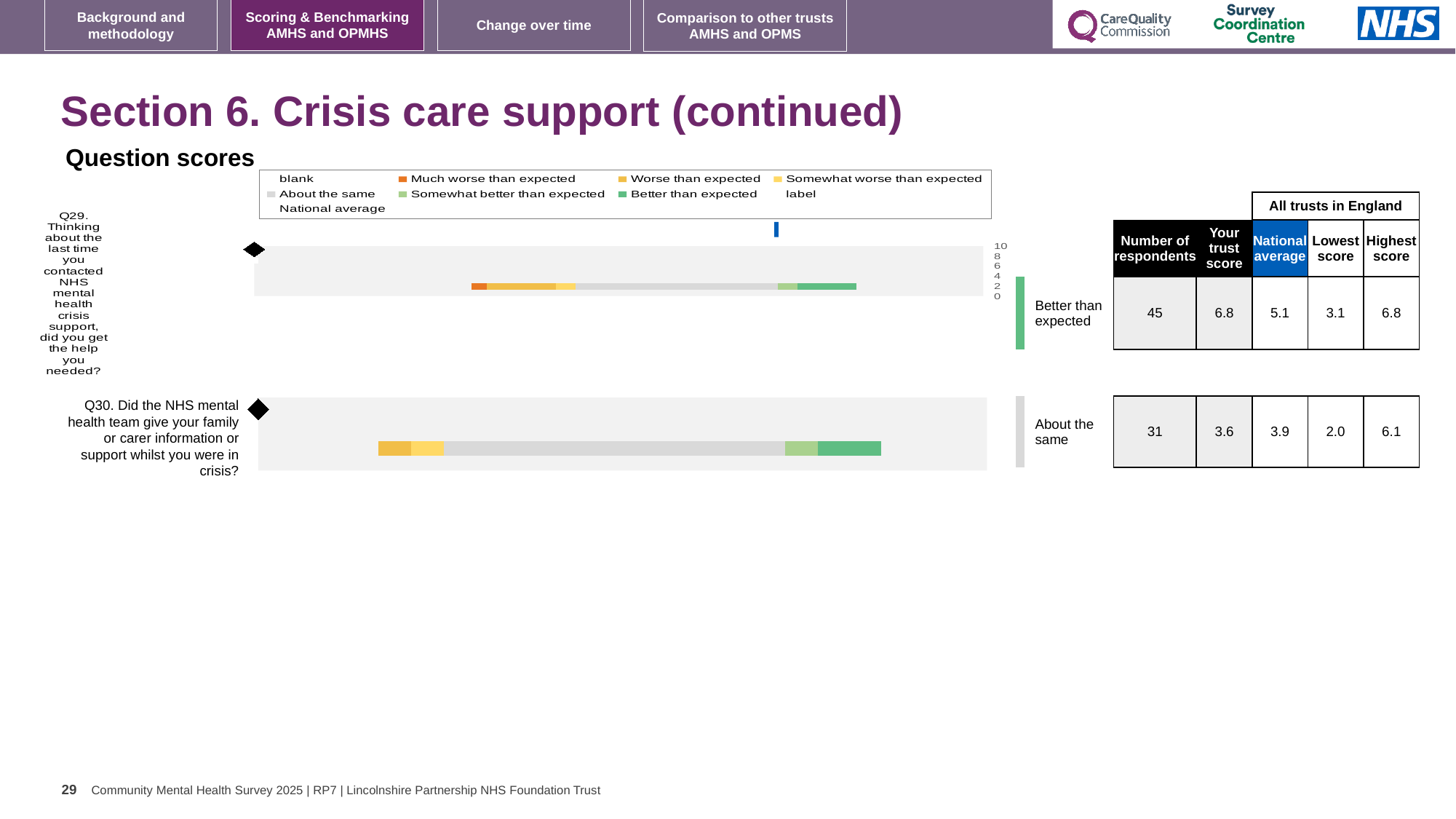
What is the national average score for Q30 (information or support for family or carer whilst in crisis)? 3.9 What is the lowest score across all trusts in England for Q29? 3.1 What is the trust score for Q29 (did you get the help you needed from NHS mental health crisis support)? 6.8 Which legend entry is shown in orange? Much worse than expected Which benchmark category is Q30 placed in? About the same Which benchmark category is Q29 placed in? Better than expected What is the highest score across all trusts in England for Q30? 6.1 How many questions are plotted in the question scores chart? 2 What kind of chart is used to show the question scores on this slide? bar chart What is the difference between the trust score and the national average for Q29? 1.7 For Q29, which is larger: the trust score or the national average? the trust score How many respondents answered Q30? 31